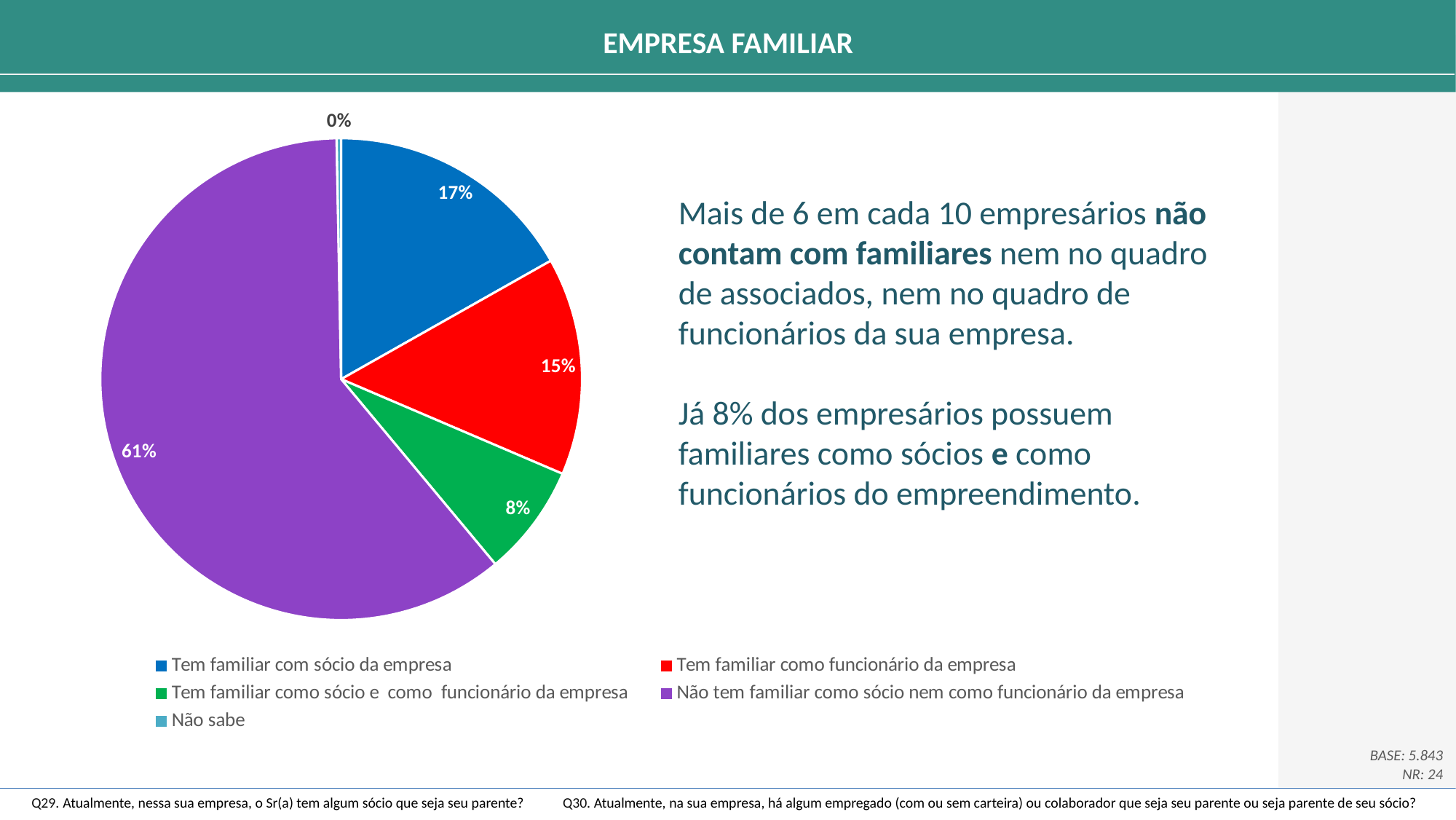
What percentage of the pie is 'Não tem familiar como sócio nem como funcionário da empresa'? 61% What is the difference in percentage points between 'Não tem familiar como sócio nem como funcionário da empresa' and 'Tem familiar com sócio da empresa'? 44 What colour is the slice for 'Não tem familiar como sócio nem como funcionário da empresa'? purple Which category has the largest share of the pie? Não tem familiar como sócio nem como funcionário da empresa What percentage of the pie is 'Tem familiar como sócio e como funcionário da empresa'? 8% What percentage of the pie is 'Não sabe'? 0% What percentage of the pie is 'Tem familiar como funcionário da empresa'? 15% Which category has the smallest share of the pie? Não sabe What kind of chart is shown on the slide? pie chart How many categories does the legend of the pie chart list? 5 Which is larger: 'Tem familiar com sócio da empresa' or 'Tem familiar como funcionário da empresa'? Tem familiar com sócio da empresa What percentage of the pie is 'Tem familiar com sócio da empresa'? 17%